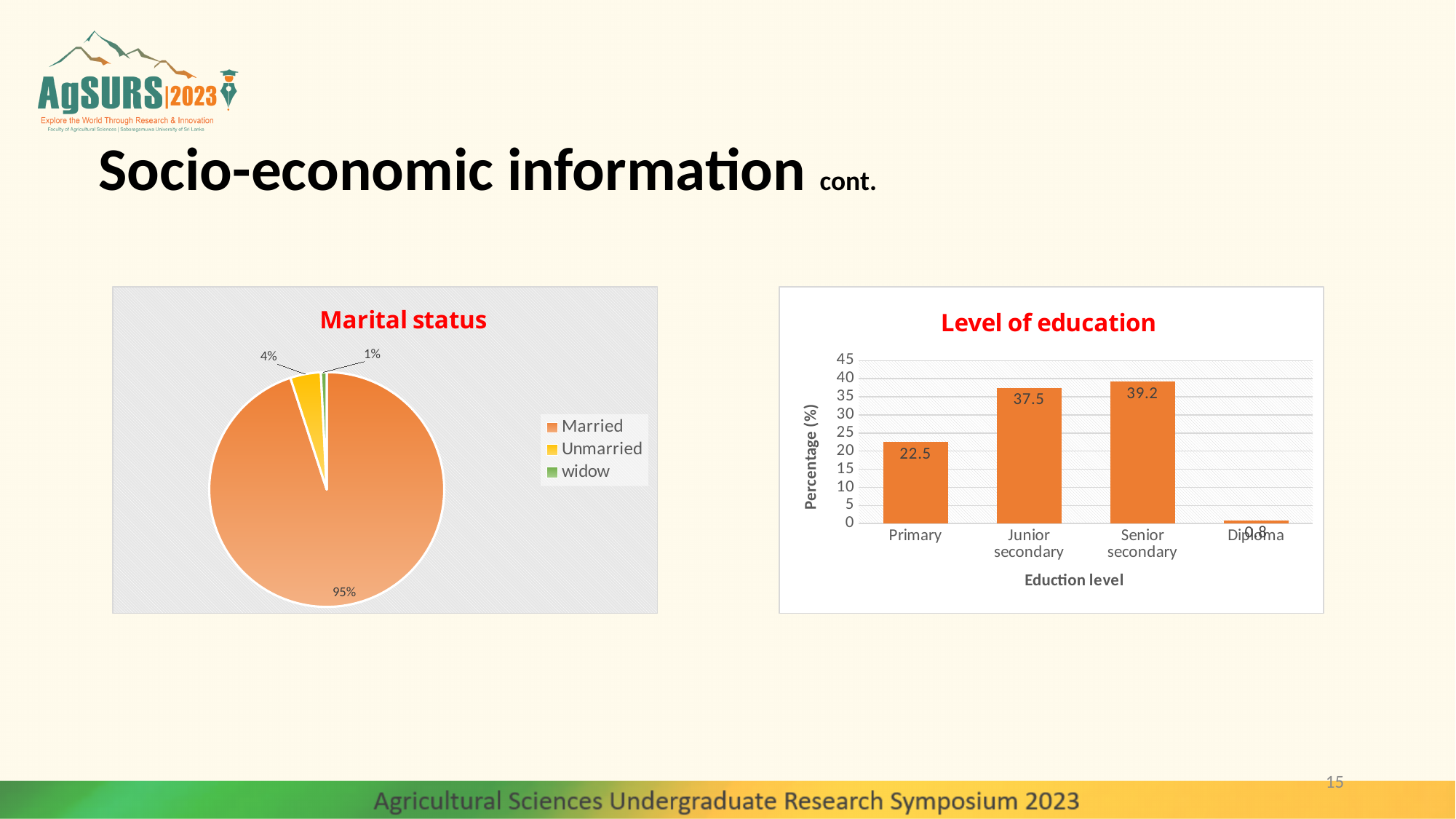
In the 'Marital status' chart, which category has the smallest slice? widow In the 'Marital status' chart, how many categories does the legend list? 3 In the 'Level of education' chart, what is the difference between the values for Senior secondary and Primary? 16.7 In the 'Level of education' chart, what is the value for Diploma? 0.8 In the 'Level of education' chart, what is the value for Junior secondary? 37.5 In the 'Level of education' chart, which education level has the highest percentage? Senior secondary What kind of chart is the 'Marital status' chart? Pie chart In the 'Marital status' chart, what percentage of respondents are widow? 1% In the 'Marital status' chart, what percentage of respondents are Married? 95% What kind of chart is the 'Level of education' chart? Bar chart In the 'Marital status' chart, what percentage of respondents are Unmarried? 4% In the 'Level of education' chart, how many education levels are shown on the x axis? 4